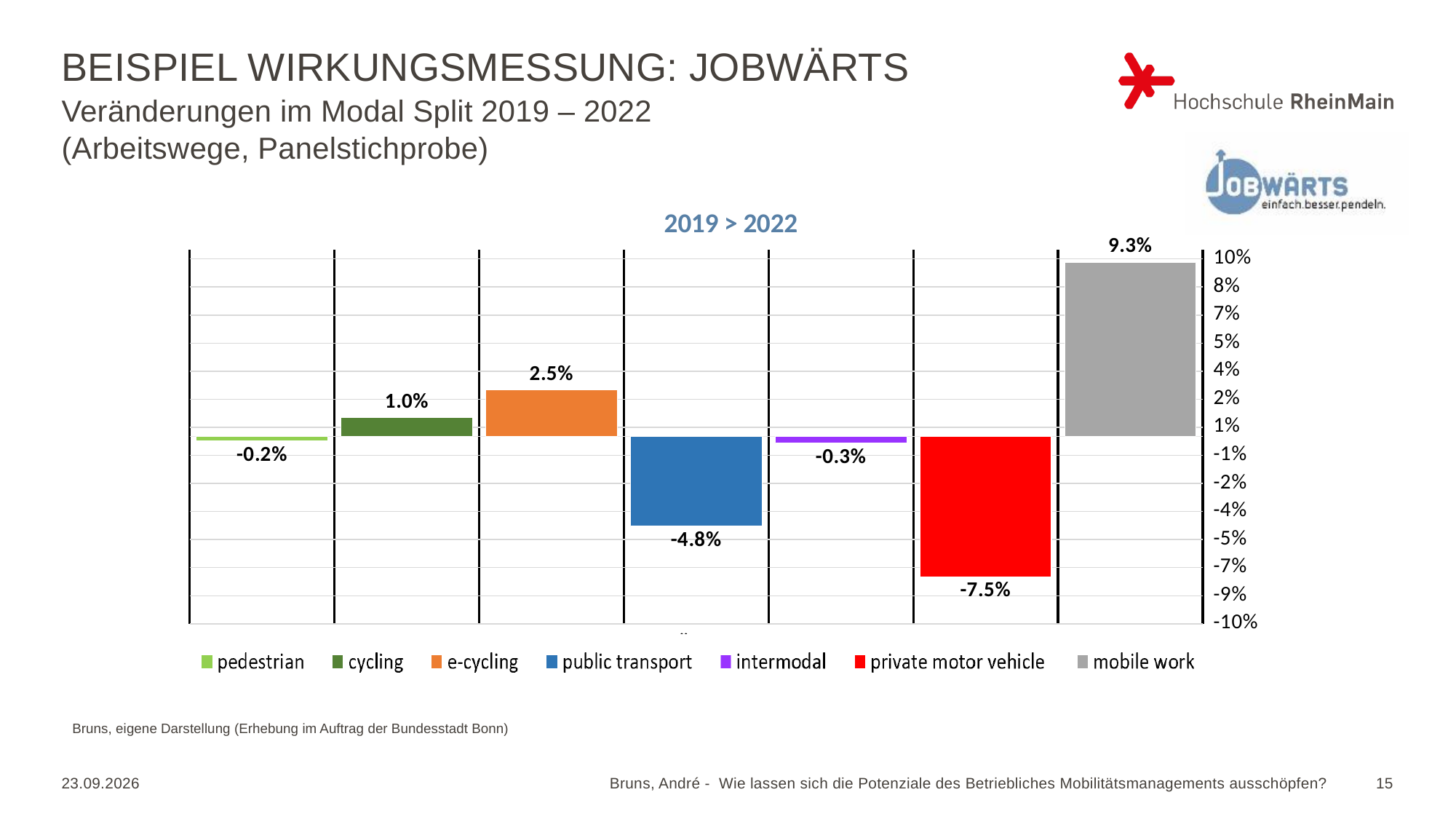
What is the value for intermodal? -0.3% What is the value for public transport? -4.8% What is the value for private motor vehicle? -7.5% What is the difference between the values for e-cycling and cycling? 1.5% Which category has the highest value? mobile work What is the title shown above the chart? 2019 > 2022 How many series does the legend list? 7 Which category has the lowest value? private motor vehicle Which is larger, the value for cycling or the value for e-cycling? e-cycling What is the value for mobile work? 9.3% What is the value for e-cycling? 2.5% What kind of chart is shown on the slide? bar chart